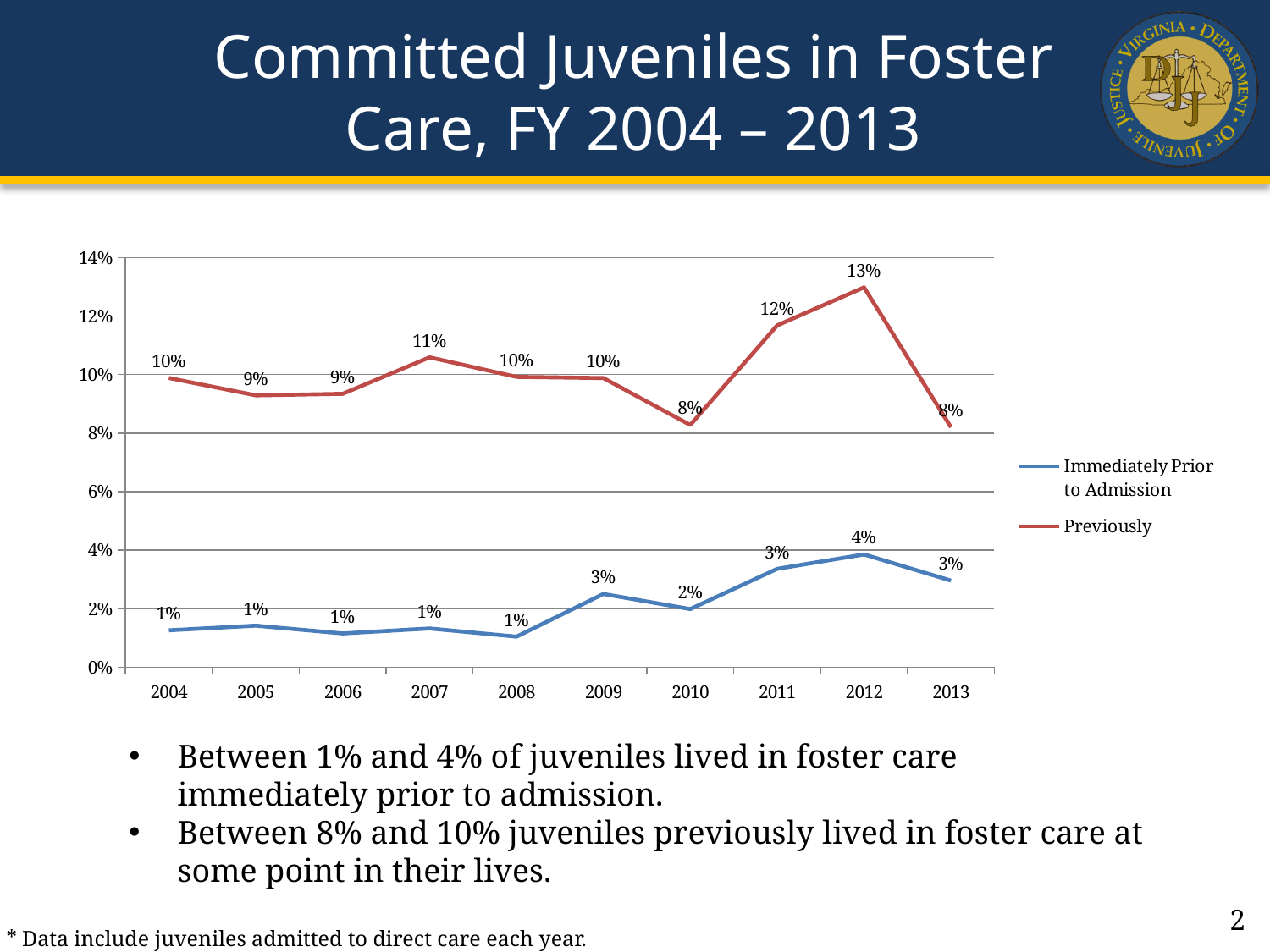
What is the value for the Immediately Prior to Admission series in 2009? 3% In which year does the Previously series reach its highest value? 2012 Which is larger for the Previously series: the value in 2011 or the value in 2010? 2011 Does the Previously series rise or fall from 2012 to 2013? Fall In which year does the Immediately Prior to Admission series reach its highest value? 2012 How many years are plotted along the x axis? 10 What is the value for the Previously series in 2007? 11% Which colour is used for the Previously series line? Red How many series does the legend list? 2 What type of chart is shown on the slide? Line chart What is the value for the Previously series in 2012? 13% What is the difference between the Previously value and the Immediately Prior to Admission value in 2012? 9%